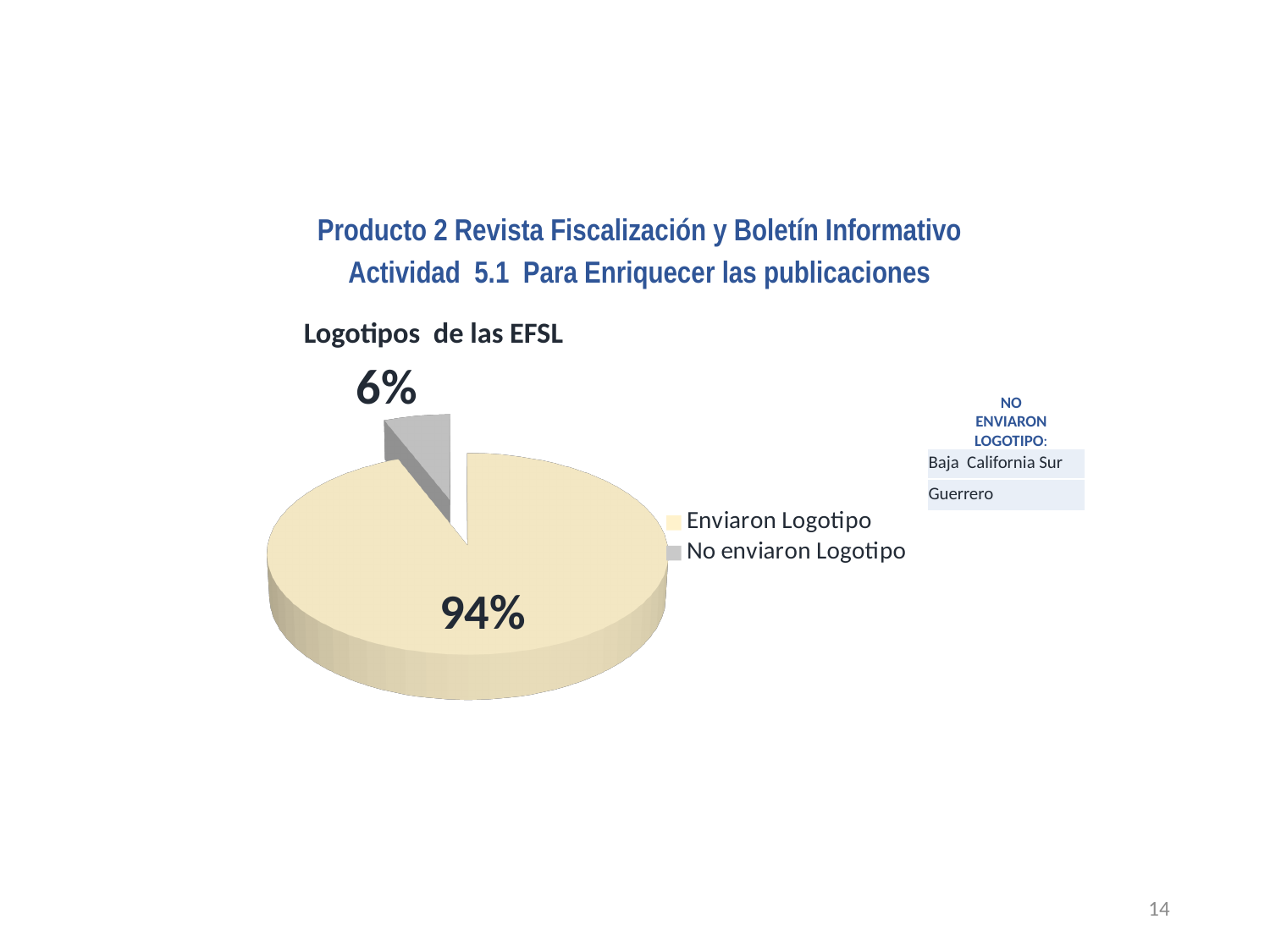
What share of the pie does the "No enviaron Logotipo" slice represent? 6% How many entries does the legend list? 2 Which is larger, the "Enviaron Logotipo" slice or the "No enviaron Logotipo" slice? Enviaron Logotipo Which slice of the pie is the largest? Enviaron Logotipo Which slice of the pie is the smallest? No enviaron Logotipo What is the difference in percentage points between the "Enviaron Logotipo" and "No enviaron Logotipo" slices? 88 What percentage of the pie is labelled "Enviaron Logotipo"? 94% What kind of chart is shown on the slide? pie chart What colour is the "Enviaron Logotipo" slice? beige What percentage of the pie is labelled "No enviaron Logotipo"? 6% How many slices does the pie chart have? 2 What is the title of the chart? Logotipos de las EFSL